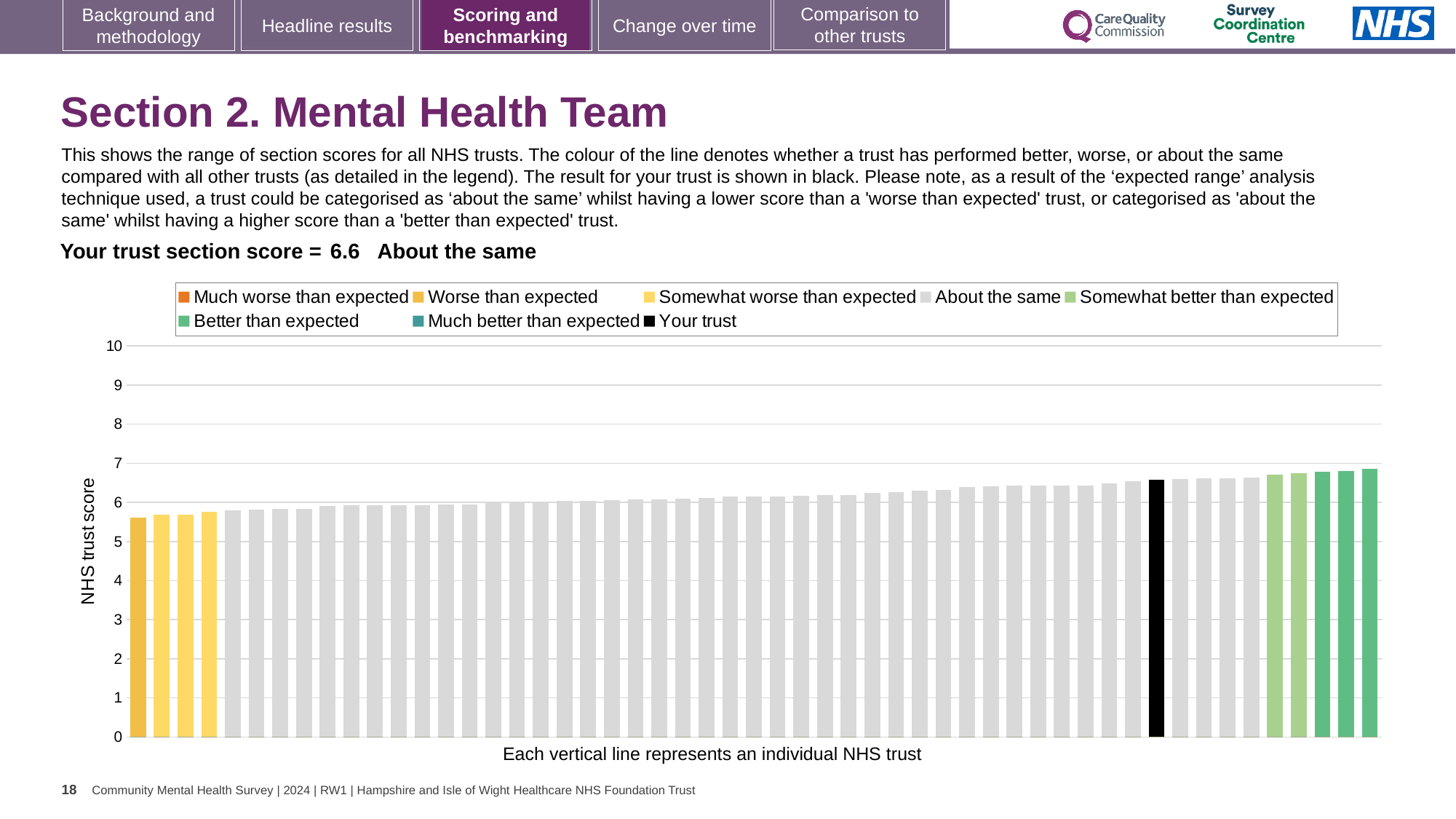
Do the bar values rise or fall from left to right along the x axis? rise What is the label of the vertical axis? NHS trust score How many entries does the chart legend list? 8 Which legend category do the highest bars on the right of the chart belong to? Better than expected What is the section score for your trust shown on the slide? 6.6 Is the value for your trust (the black bar) greater or less than 6? greater Is the value of the lowest bar in the chart greater or less than 6? less Which colour is used for the bar representing your trust? black Is the value of the highest bar in the chart greater or less than 7? less What does each vertical line in the chart represent, according to the x-axis label? an individual NHS trust What kind of chart is shown on the slide? bar chart How is your trust's score categorised compared with other trusts? About the same